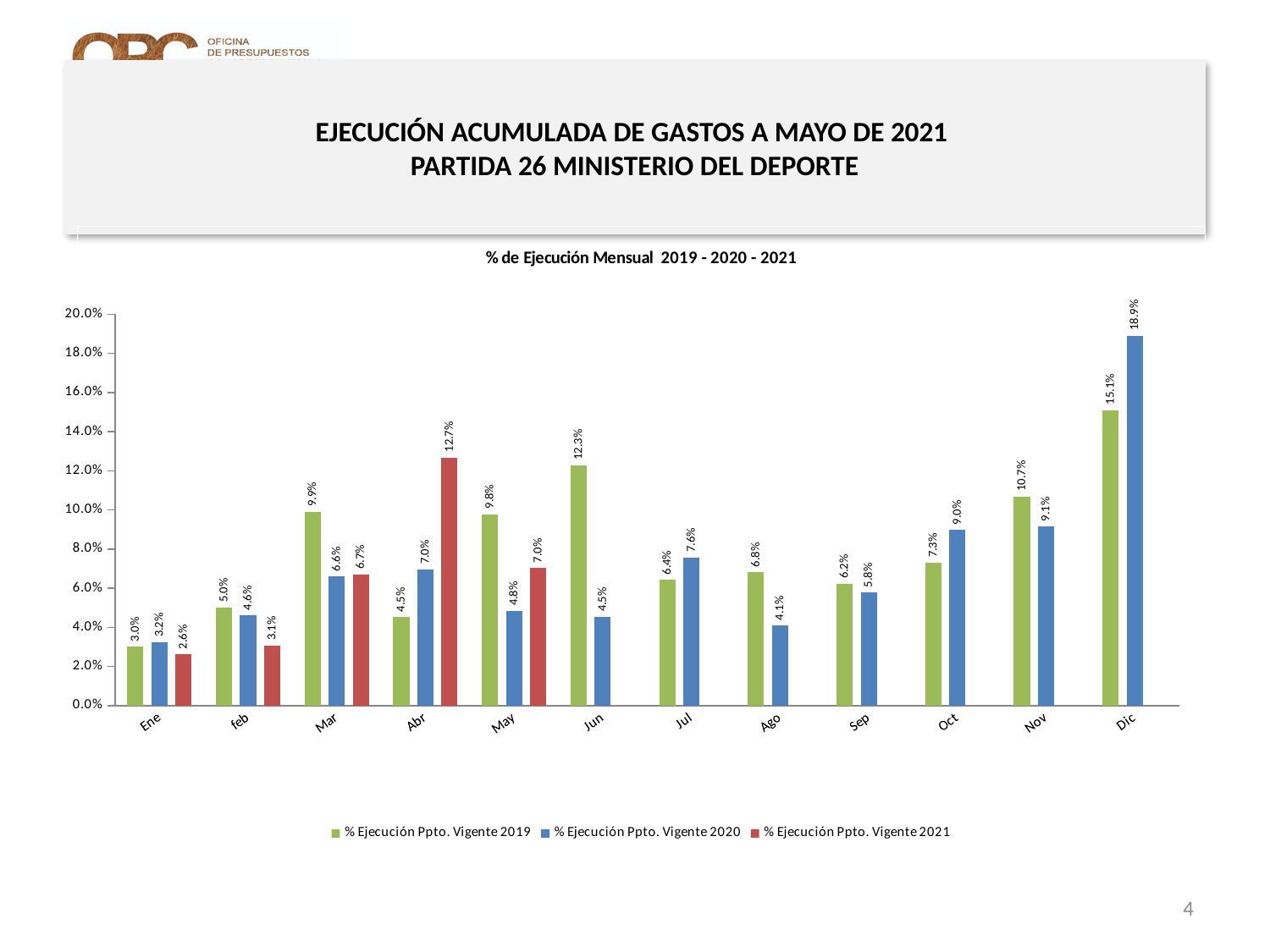
Is the value for % Ejecución Ppto. Vigente 2019 in Nov greater or less than 10.0%? greater How many series does the legend list? 3 Which is larger in Mar: the 2019 value or the 2020 value? 2019 value What kind of chart is shown on the slide? Bar chart What is the value for % Ejecución Ppto. Vigente 2019 in Jun? 12.3% What is the value for % Ejecución Ppto. Vigente 2021 in Abr? 12.7% What is the title of the chart? % de Ejecución Mensual 2019 - 2020 - 2021 Which month has the highest value for % Ejecución Ppto. Vigente 2020? Dic What is the value for % Ejecución Ppto. Vigente 2020 in Nov? 9.1% How many months are shown on the x axis? 12 What is the difference between the 2020 and 2019 values in Dic? 3.8% Which month has the lowest value for % Ejecución Ppto. Vigente 2019? Ene